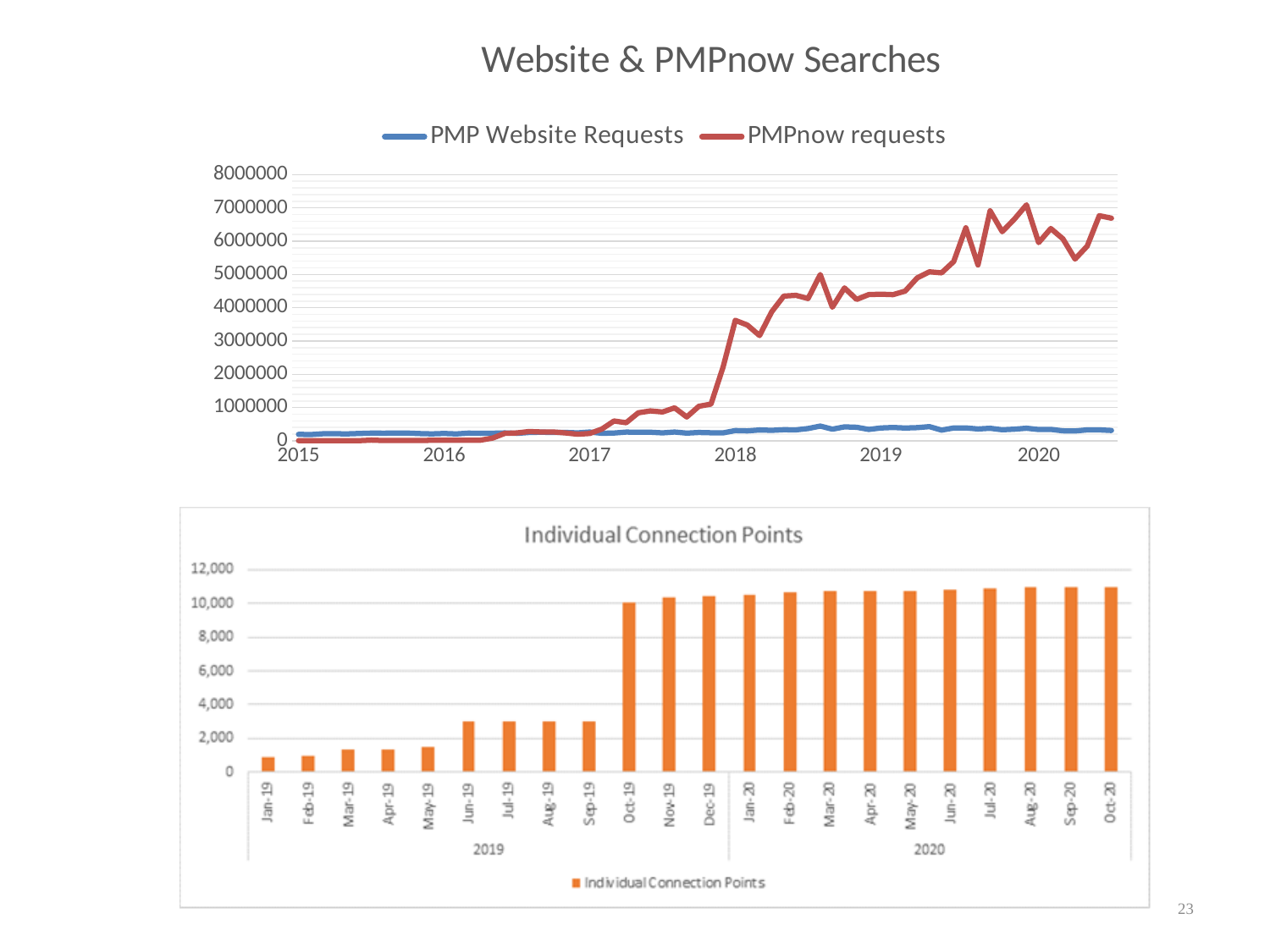
In the top chart "Website & PMPnow Searches", which series reaches higher values by 2020, PMP Website Requests or PMPnow requests? PMPnow requests In the bottom chart "Individual Connection Points", how many monthly bars are plotted? 22 In the bottom chart "Individual Connection Points", do the values generally rise or fall from Jan-19 to Oct-20? rise What kind of chart is the top chart titled "Website & PMPnow Searches"? line chart In the bottom chart "Individual Connection Points", is the value for Jan-19 greater or less than 2,000? less In the top chart "Website & PMPnow Searches", is the value of PMPnow requests at the 2020 tick greater or less than 5000000? greater In the bottom chart "Individual Connection Points", is the value for Oct-20 greater or less than 8,000? greater In the top chart "Website & PMPnow Searches", do PMPnow requests generally rise or fall from 2017 to 2020? rise What kind of chart is the bottom chart titled "Individual Connection Points"? bar chart In the bottom chart "Individual Connection Points", which is larger, the value for Jun-19 or the value for Oct-19? Oct-19 In the top chart "Website & PMPnow Searches", how many series does the legend list? 2